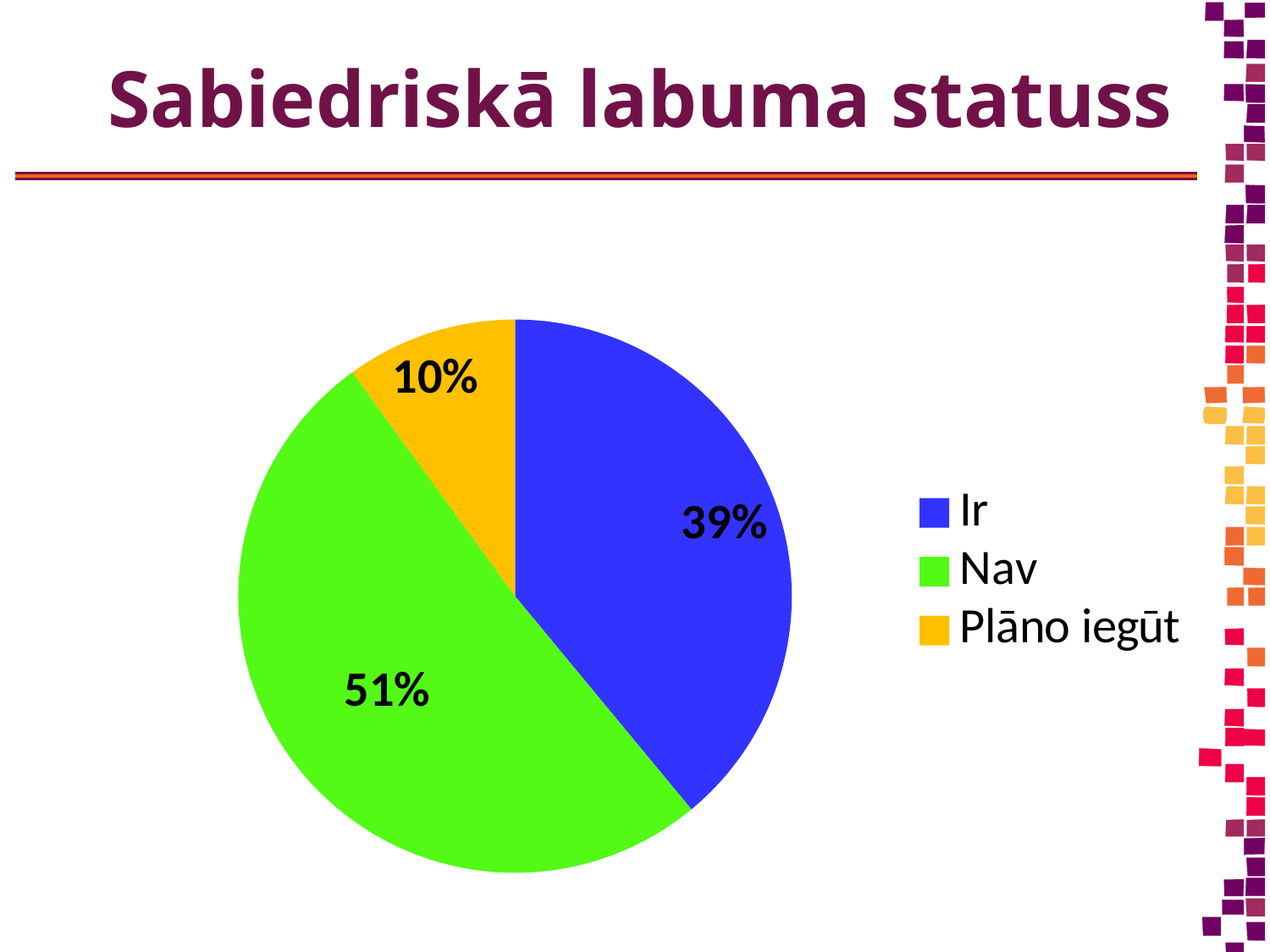
What colour is the "Nav" slice in the pie chart? green Which category has the smallest slice of the pie? Plāno iegūt What is the difference in percentage points between the "Nav" and "Ir" slices? 12 What is the title of the slide containing the pie chart? Sabiedriskā labuma statuss What share of the pie does "Ir" have? 39% How many categories does the pie chart have? 3 What is the difference in percentage points between the "Ir" and "Plāno iegūt" slices? 29 What share of the pie does "Plāno iegūt" have? 10% Which category has the largest slice of the pie? Nav Which is larger, the "Ir" slice or the "Plāno iegūt" slice? Ir What kind of chart is shown on the slide? pie chart What share of the pie does "Nav" have? 51%